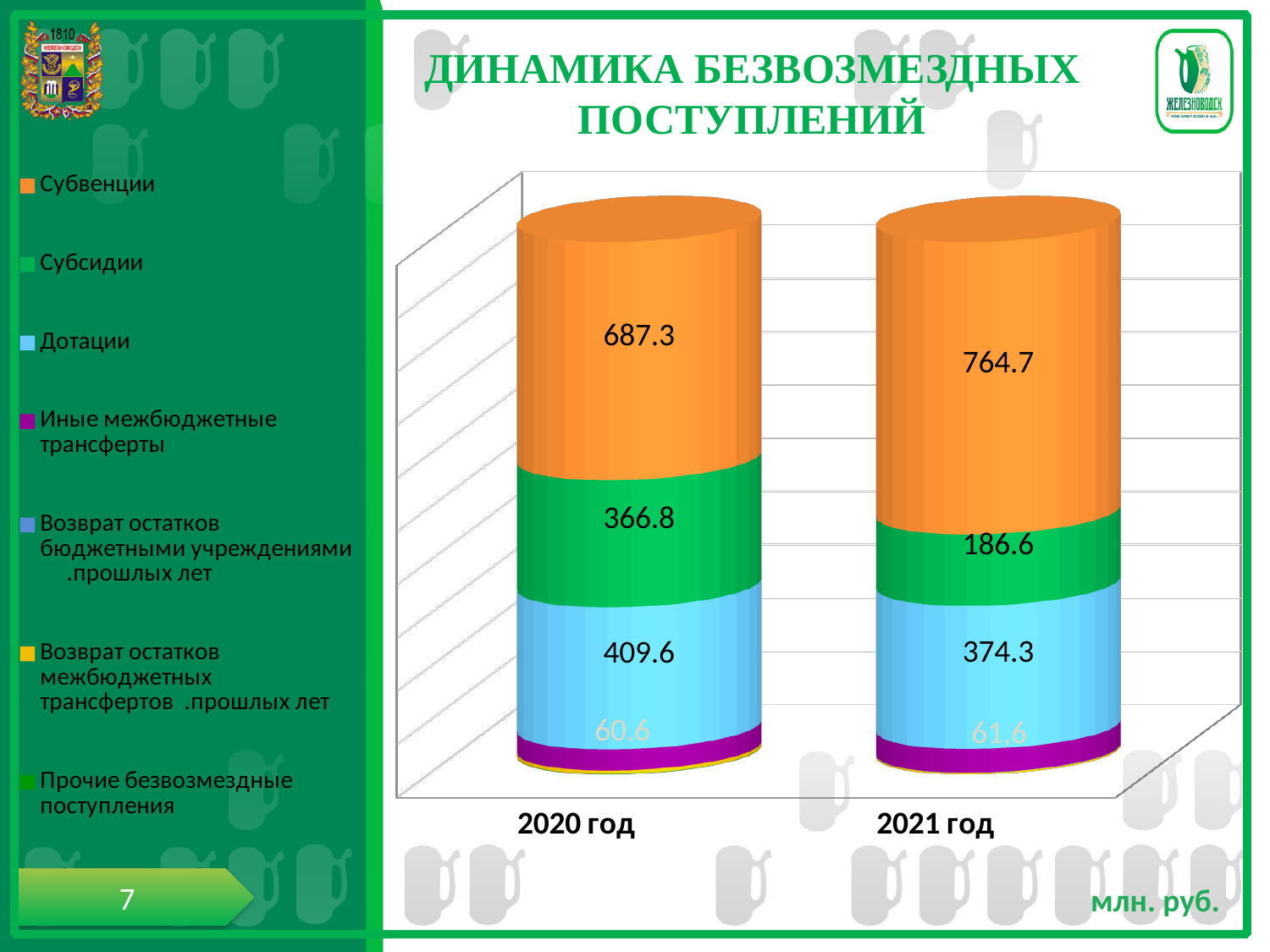
How many years (categories) are shown on the x axis? 2 By how much did Субвенции increase from 2020 год to 2021 год? 77.4 How many series does the legend list? 7 What is the value for Иные межбюджетные трансферты in 2020 год? 60.6 What is the value for Дотации in 2020 год? 409.6 What is the value for Субсидии in 2021 год? 186.6 What kind of chart is shown on the slide? Stacked bar chart What is the value for Субвенции in 2021 год? 764.7 Which series has the largest segment in the 2021 год bar? Субвенции What is the value for Субвенции in 2020 год? 687.3 Which year has the larger value for Субсидии, 2020 год or 2021 год? 2020 год What is the difference between Дотации in 2020 год and 2021 год? 35.3